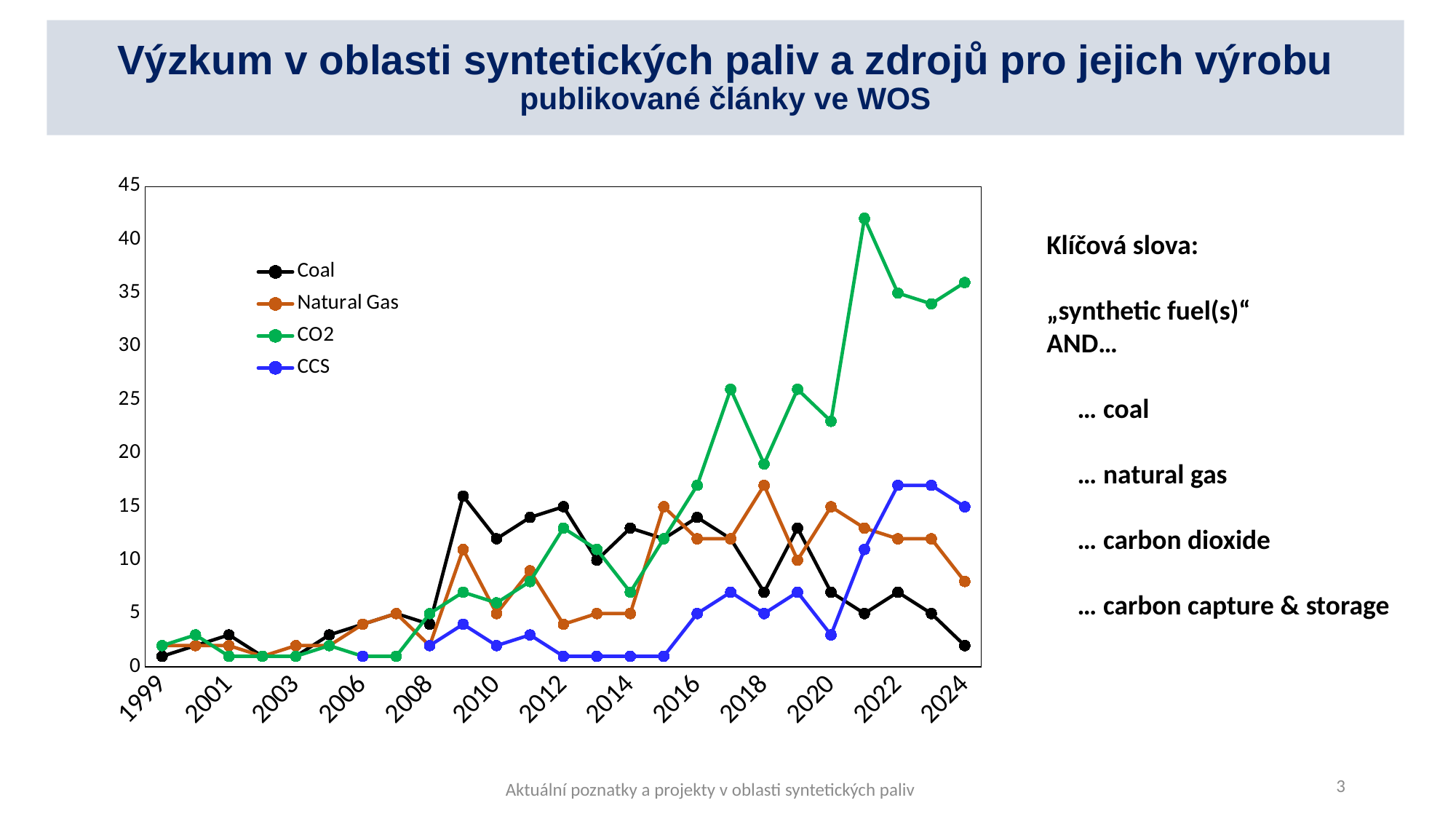
In 2018, which is larger: the value for Natural Gas or the value for Coal? Natural Gas How many series does the chart legend list? 4 Which series has the highest value in 2024? CO2 Is the value for CCS in 2022 greater or less than 10? greater Does the CO2 series generally rise or fall between 2014 and 2024? rise What kind of chart is shown on the slide? line chart Which series are listed in the chart legend? Coal, Natural Gas, CO2, CCS Is the value for CO2 in 2024 greater or less than 30? greater In 2022, which is larger: the value for CCS or the value for Coal? CCS Is the value for Coal in 2024 greater or less than 5? less Which series reaches the highest value anywhere on the chart? CO2 Which series has the lowest value in 2024? Coal